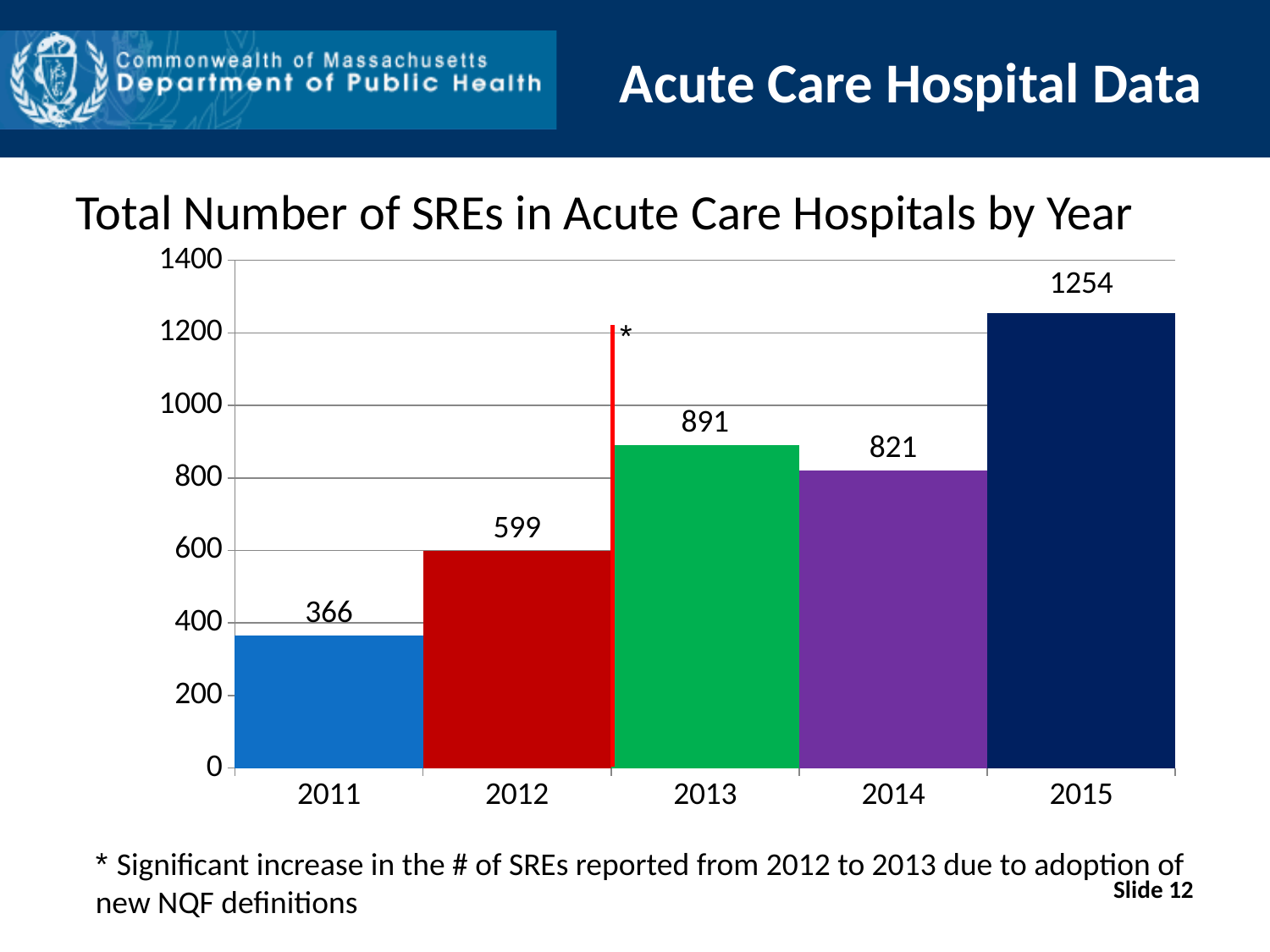
What is the title of the chart? Total Number of SREs in Acute Care Hospitals by Year What kind of chart is shown on the slide? Bar chart How many years are shown in the chart? 5 What is the total number of SREs in acute care hospitals in 2013? 891 What is the difference in the number of SREs between 2015 and 2014? 433 What is the total number of SREs in acute care hospitals in 2015? 1254 Which year has the highest total number of SREs? 2015 What is the total number of SREs in acute care hospitals in 2011? 366 Which year had more SREs, 2013 or 2014? 2013 Is the number of SREs in 2012 greater or less than 600? less What is the difference in the number of SREs between 2012 and 2013? 292 Which year has the lowest total number of SREs? 2011